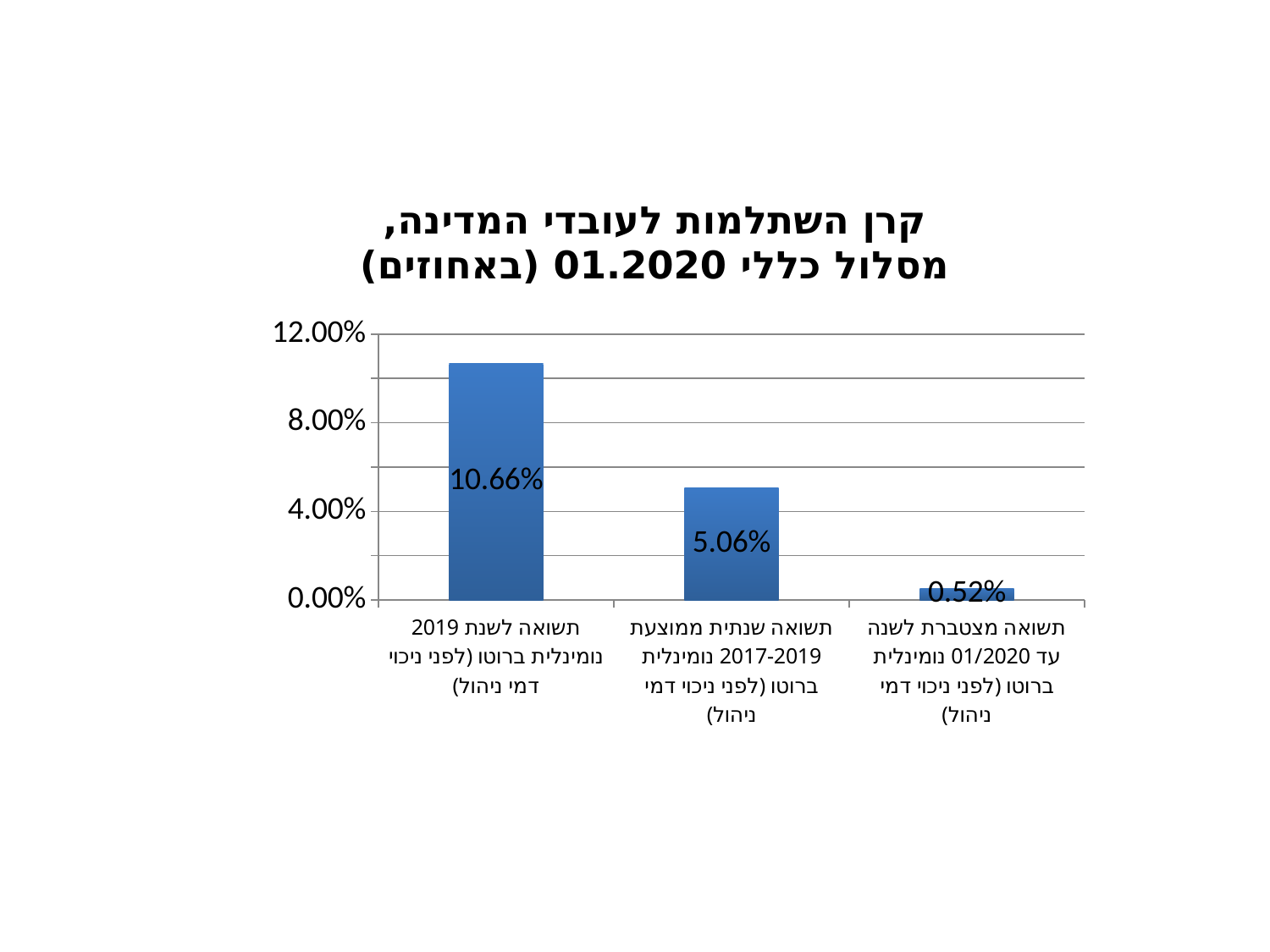
What is the difference between the 2019 return (10.66%) and the 2017-2019 average annual return (5.06%)? 5.60% What is the value for the average annual nominal gross return 2017-2019 (תשואה שנתית ממוצעת 2017-2019)? 5.06% Do the values rise or fall from left to right across the categories? fall What is the value for the 2019 nominal gross return (תשואה לשנת 2019 נומינלית ברוטו)? 10.66% What is the title of the chart? קרן השתלמות לעובדי המדינה, מסלול כללי 01.2020 (באחוזים) Which category has the lowest value? תשואה מצטברת לשנה עד 01/2020 נומינלית ברוטו (לפני ניכוי דמי ניהול) What is the value for the cumulative nominal gross return for the year to 01/2020 (תשואה מצטברת לשנה עד 01/2020)? 0.52% Which is larger: the 2017-2019 average annual return or the cumulative return to 01/2020? תשואה שנתית ממוצעת 2017-2019 Which category has the highest value? תשואה לשנת 2019 נומינלית ברוטו (לפני ניכוי דמי ניהול) How many categories (bars) are shown in the chart? 3 What kind of chart is shown on the slide? bar chart Is the value for the 2019 nominal gross return greater or less than 8.00%? greater